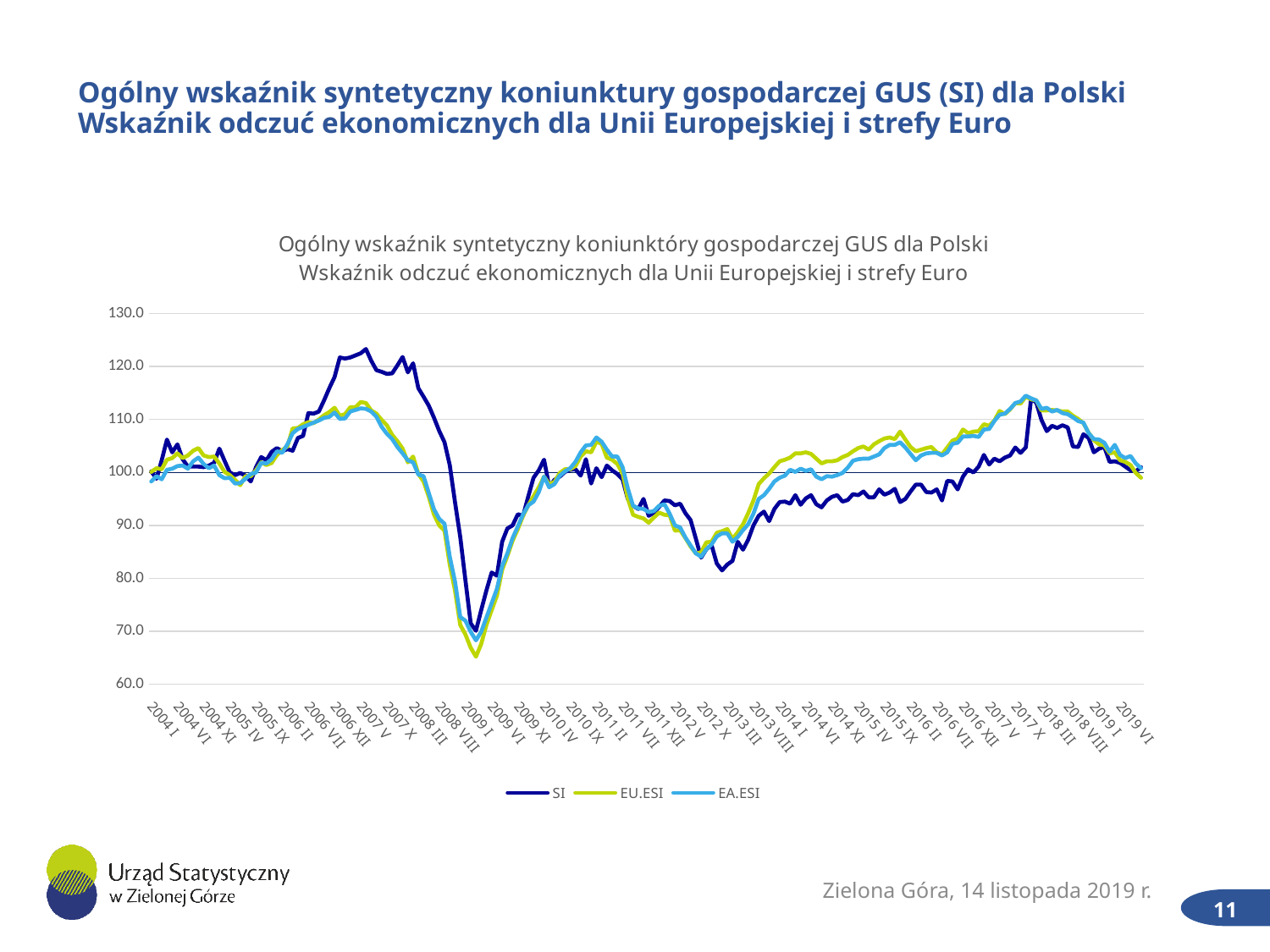
Is the value of the SI series at 2014 I greater or less than 90? greater Which series reaches the lowest value anywhere on the chart? EU.ESI Do the series rise or fall between 2009 I and 2010 IX? rise Which series reaches the highest value anywhere on the chart? SI What kind of chart is shown on the slide? line chart What is the highest value shown on the vertical axis? 130.0 Is the value of the EU.ESI series at 2017 X greater or less than 110? greater How many series does the legend list? 3 Do the series rise or fall between 2008 III and 2009 I? fall Is the lowest value of the EU.ESI series around 2009 I greater or less than 70? less What are the names of the series listed in the legend? SI, EU.ESI, EA.ESI